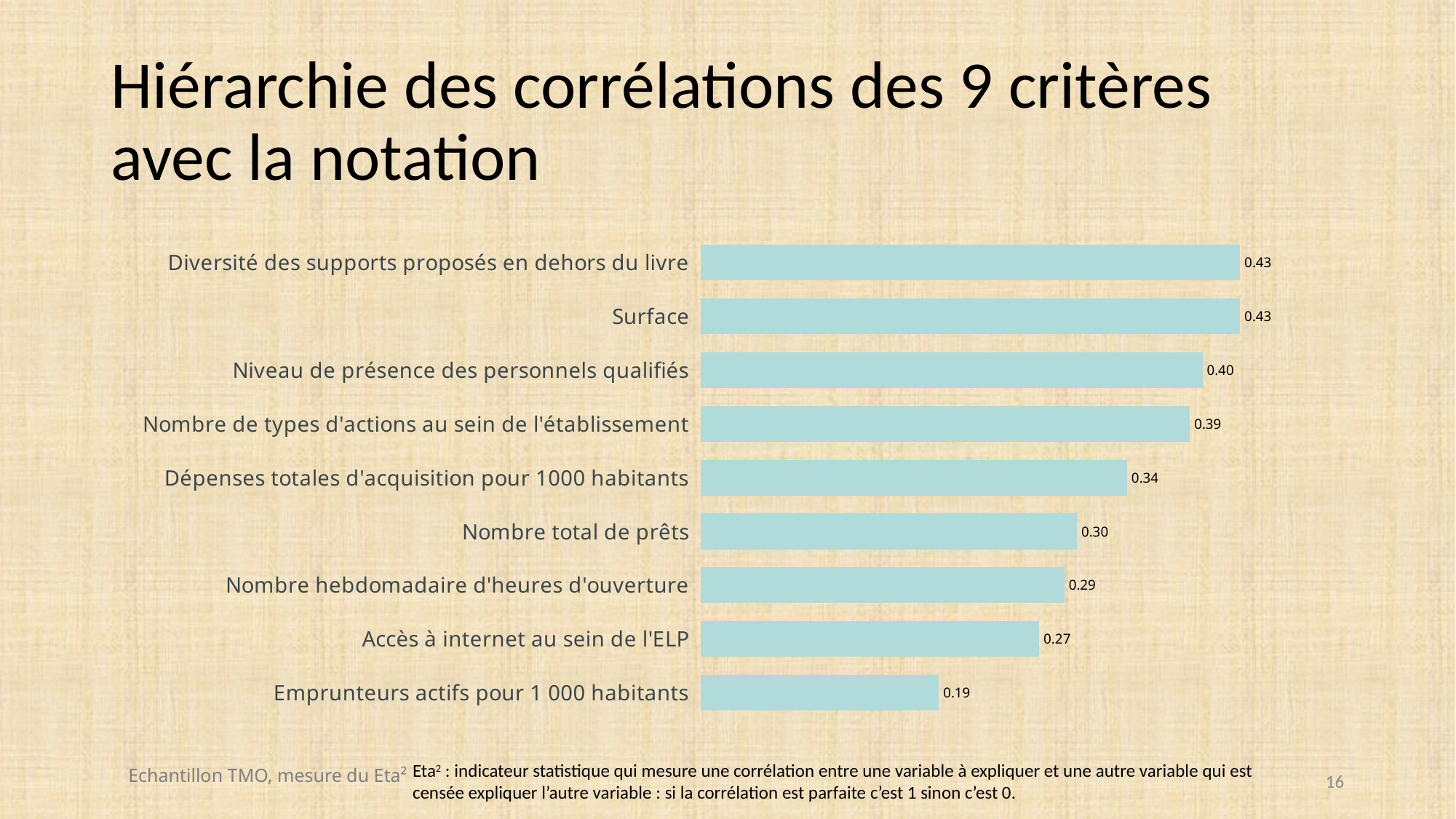
Which is larger: the value for "Nombre de types d'actions au sein de l'établissement" or the value for "Nombre hebdomadaire d'heures d'ouverture"? Nombre de types d'actions au sein de l'établissement What is the title of the slide containing the chart? Hiérarchie des corrélations des 9 critères avec la notation What is the difference between the value for "Niveau de présence des personnels qualifiés" and the value for "Dépenses totales d'acquisition pour 1000 habitants"? 0.06 What type of chart is shown on the slide? bar chart Do the values rise or fall going from the top bar to the bottom bar? fall What is the value for "Niveau de présence des personnels qualifiés"? 0.40 What is the difference between the value for "Diversité des supports proposés en dehors du livre" and the value for "Emprunteurs actifs pour 1 000 habitants"? 0.24 Which category has the lowest value? Emprunteurs actifs pour 1 000 habitants How many categories are shown in the chart? 9 What is the value for "Nombre total de prêts"? 0.30 What is the value for "Surface"? 0.43 What is the value for "Accès à internet au sein de l'ELP"? 0.27